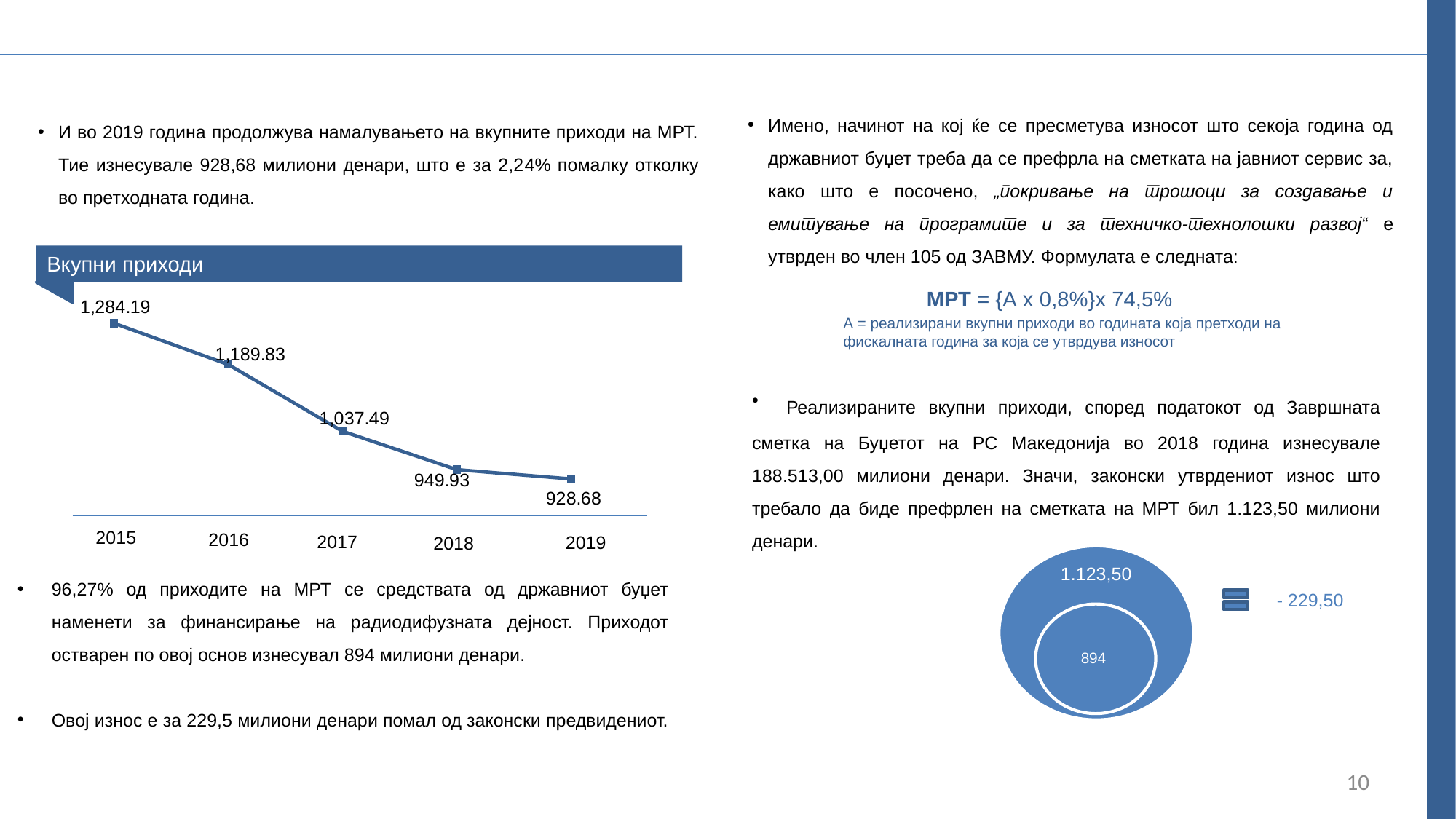
In the 'Вкупни приходи' chart, which is larger, the value for 2016 or the value for 2018? 2016 How many data points are plotted in the 'Вкупни приходи' chart? 5 In the 'Вкупни приходи' chart, what is the value for 2017? 1,037.49 In the 'Вкупни приходи' chart, what is the difference between the 2015 and 2019 values? 355.51 In the 'Вкупни приходи' chart, do the values rise or fall from 2015 to 2019? Fall In the 'Вкупни приходи' chart, which year has the highest value? 2015 What type of chart is 'Вкупни приходи'? Line chart In the 'Вкупни приходи' chart, what is the value for 2015? 1,284.19 In the 'Вкупни приходи' chart, which year has the lowest value? 2019 In the 'Вкупни приходи' chart, what is the difference between the 2016 and 2017 values? 152.34 What is the title of the line chart on the left side of the slide? Вкупни приходи In the 'Вкупни приходи' chart, what is the value for 2019? 928.68